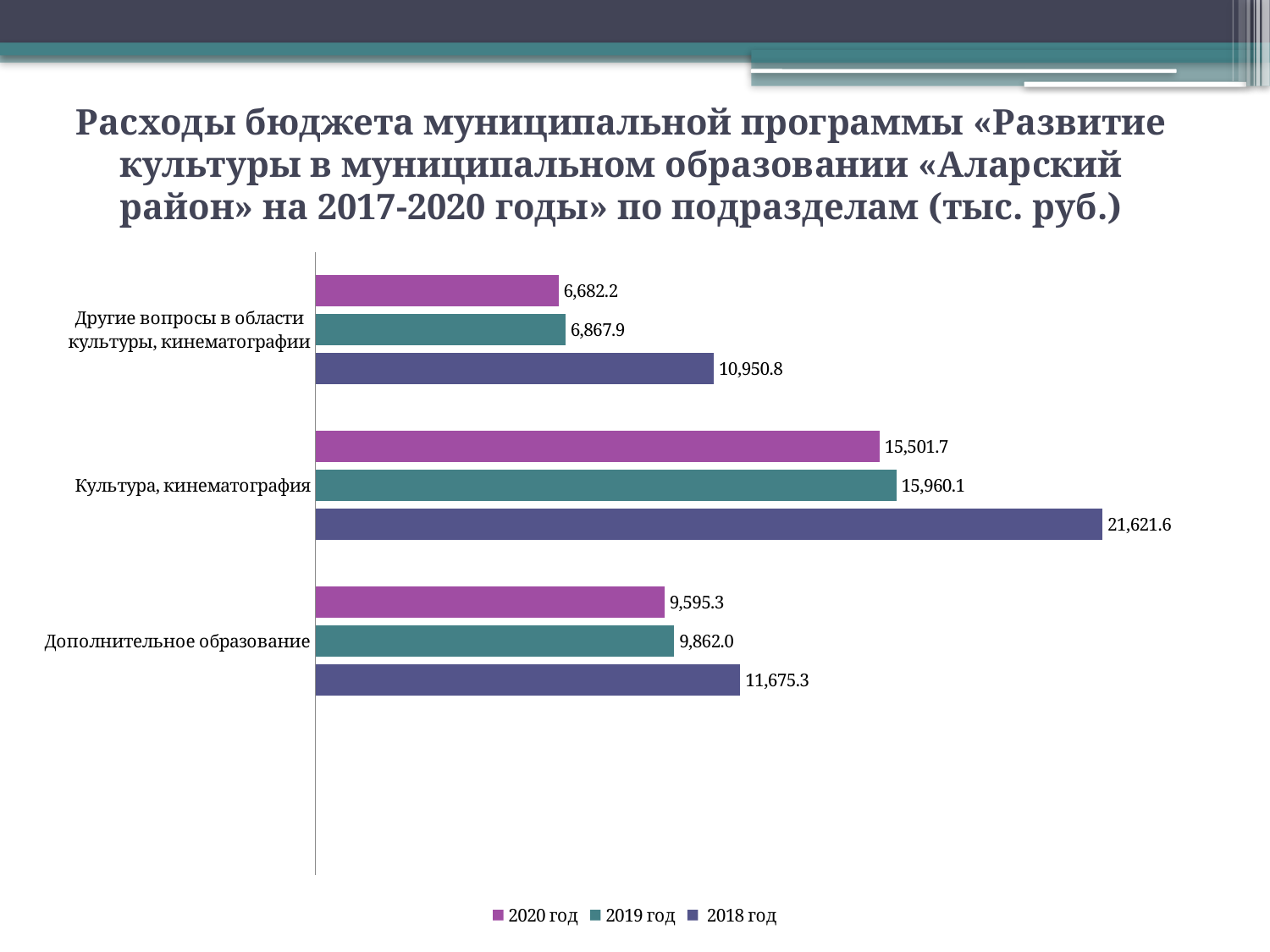
What type of chart is shown on the slide? Bar chart What is the difference between the 2018 год and 2020 год values for «Культура, кинематография»? 6,119.9 Which is larger for «Другие вопросы в области культуры, кинематографии»: the 2018 год value or the 2019 год value? 2018 год What is the value for «Культура, кинематография» in 2018 год? 21,621.6 What is the difference between the 2018 год and 2020 год values for «Дополнительное образование»? 2,080.0 Which category has the highest value in 2019 год? Культура, кинематография How many series does the legend list? 3 Which series is shown in purple in the legend? 2020 год How many categories are shown on the chart? 3 What is the value for «Другие вопросы в области культуры, кинематографии» in 2019 год? 6,867.9 What is the value for «Дополнительное образование» in 2020 год? 9,595.3 Which category has the lowest value in 2018 год? Другие вопросы в области культуры, кинематографии